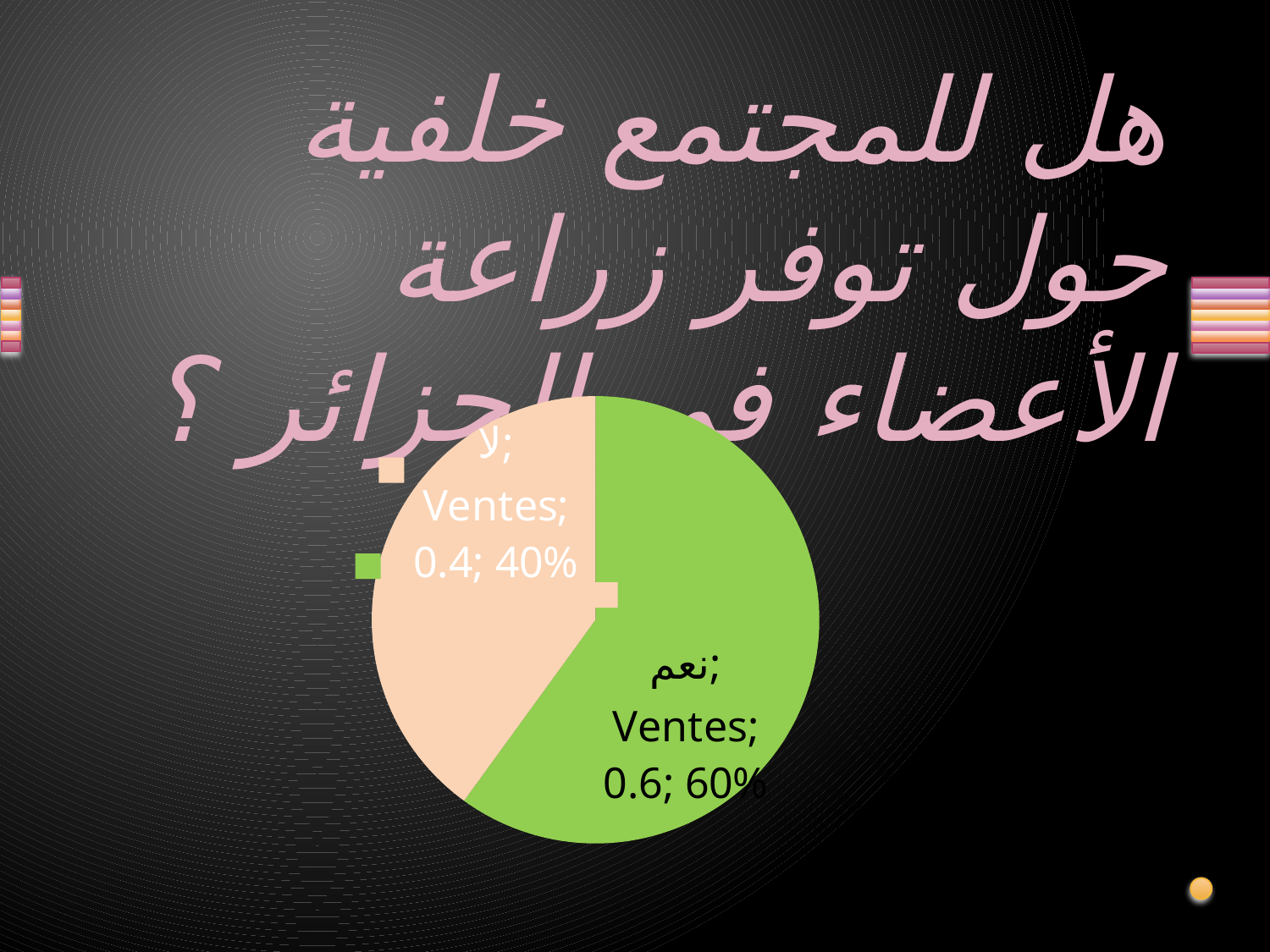
What percentage share does the نعم slice have in the pie chart? 60% What is the difference in percentage points between the نعم slice and the لا slice? 20% What colour is the نعم slice of the pie chart? green Which slice of the pie chart is the smallest? لا Which slice of the pie chart is the largest? نعم What value is printed on the data label for the نعم slice? 0.6 Which is larger, the نعم slice or the لا slice? نعم What kind of chart is shown on the slide? pie chart What percentage share does the لا slice have in the pie chart? 40% What series name appears in the data labels of the pie chart? Ventes How many slices does the pie chart have? 2 What value is printed on the data label for the لا slice? 0.4